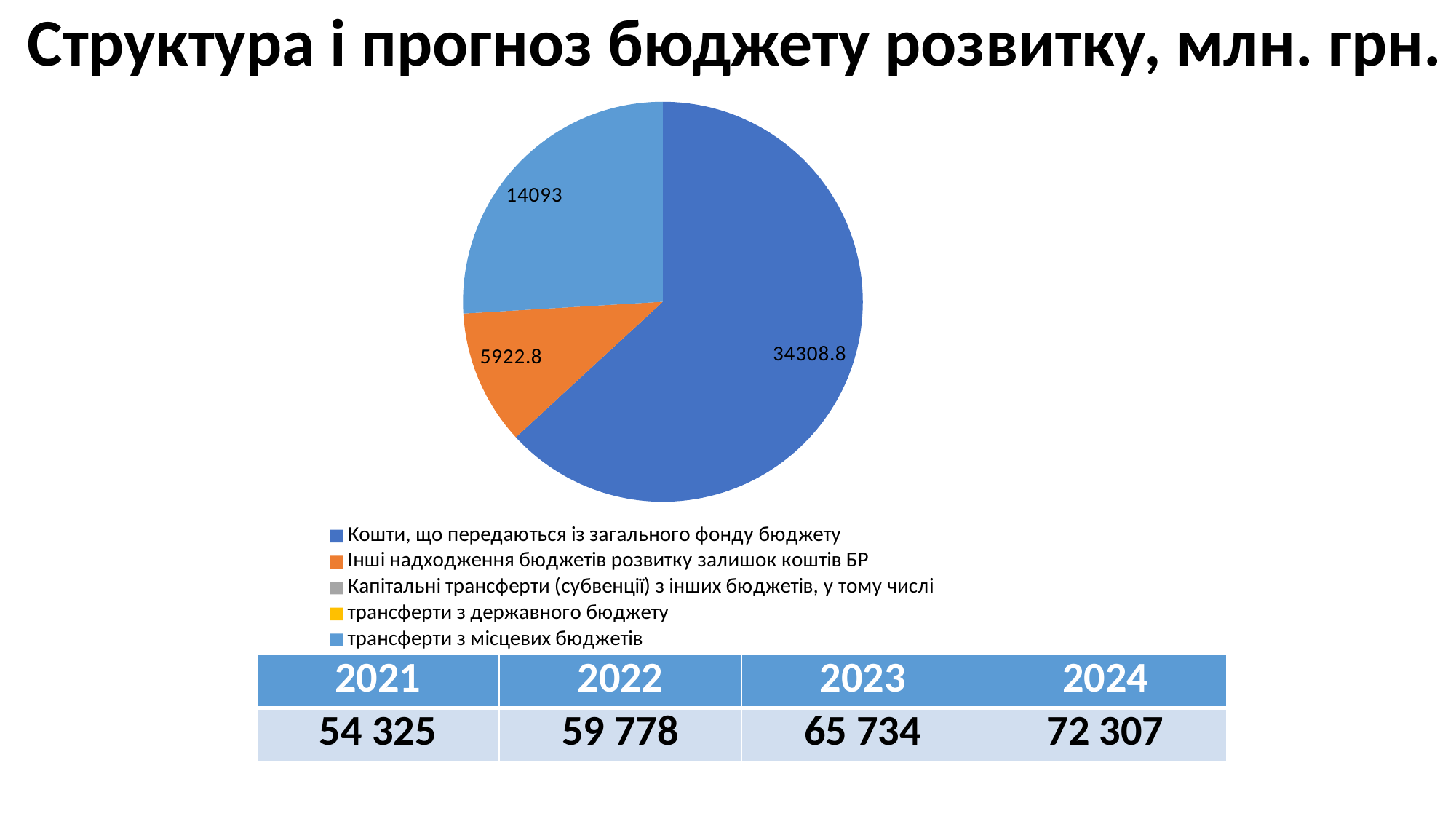
What is the value of the slice for "Інші надходження бюджетів розвитку залишок коштів БР"? 5922.8 How many slices with data labels are visible in the pie chart? 3 Which is larger: the slice for "трансферти з місцевих бюджетів" or the slice for "Інші надходження бюджетів розвитку залишок коштів БР"? трансферти з місцевих бюджетів What is the value of the slice for "трансферти з місцевих бюджетів"? 14093 What is the value of the slice for "Кошти, що передаються із загального фонду бюджету"? 34308.8 Which category has the largest slice of the pie? Кошти, що передаються із загального фонду бюджету What type of chart is shown on the slide? pie chart What is the difference between the slice for "Кошти, що передаються із загального фонду бюджету" and the slice for "трансферти з місцевих бюджетів"? 20215.8 What colour is the slice for "Інші надходження бюджетів розвитку залишок коштів БР"? orange Which labelled slice of the pie is the smallest? Інші надходження бюджетів розвитку залишок коштів БР How many entries does the legend of the pie chart list? 5 What is the difference between the slice for "трансферти з місцевих бюджетів" and the slice for "Інші надходження бюджетів розвитку залишок коштів БР"? 8170.2